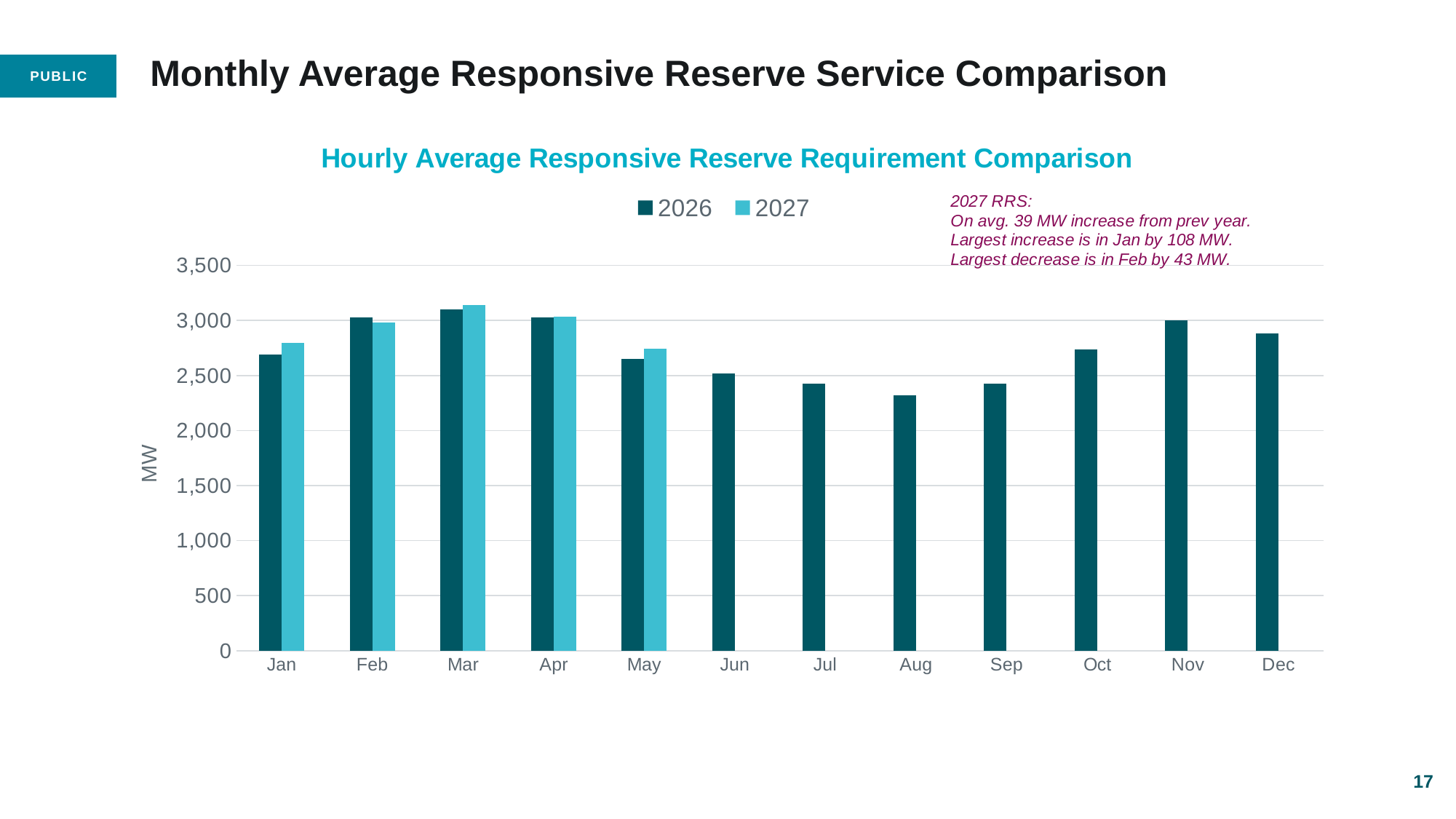
How many series does the legend list? 2 Which month has the lowest 2026 value? Aug For Jan, which series has the larger value, 2026 or 2027? 2027 Do the 2026 values rise or fall from May to Aug? fall Is the 2026 value for Mar greater or less than 3,000? greater Is the 2026 value for Aug greater or less than 2,500? less What kind of chart is shown on the slide? bar chart Is the 2026 value for Oct greater or less than 2,500? greater For Feb, which series has the larger value, 2026 or 2027? 2026 What is the label on the vertical axis? MW How many months are shown on the x axis? 12 Which month has the highest 2027 value? Mar